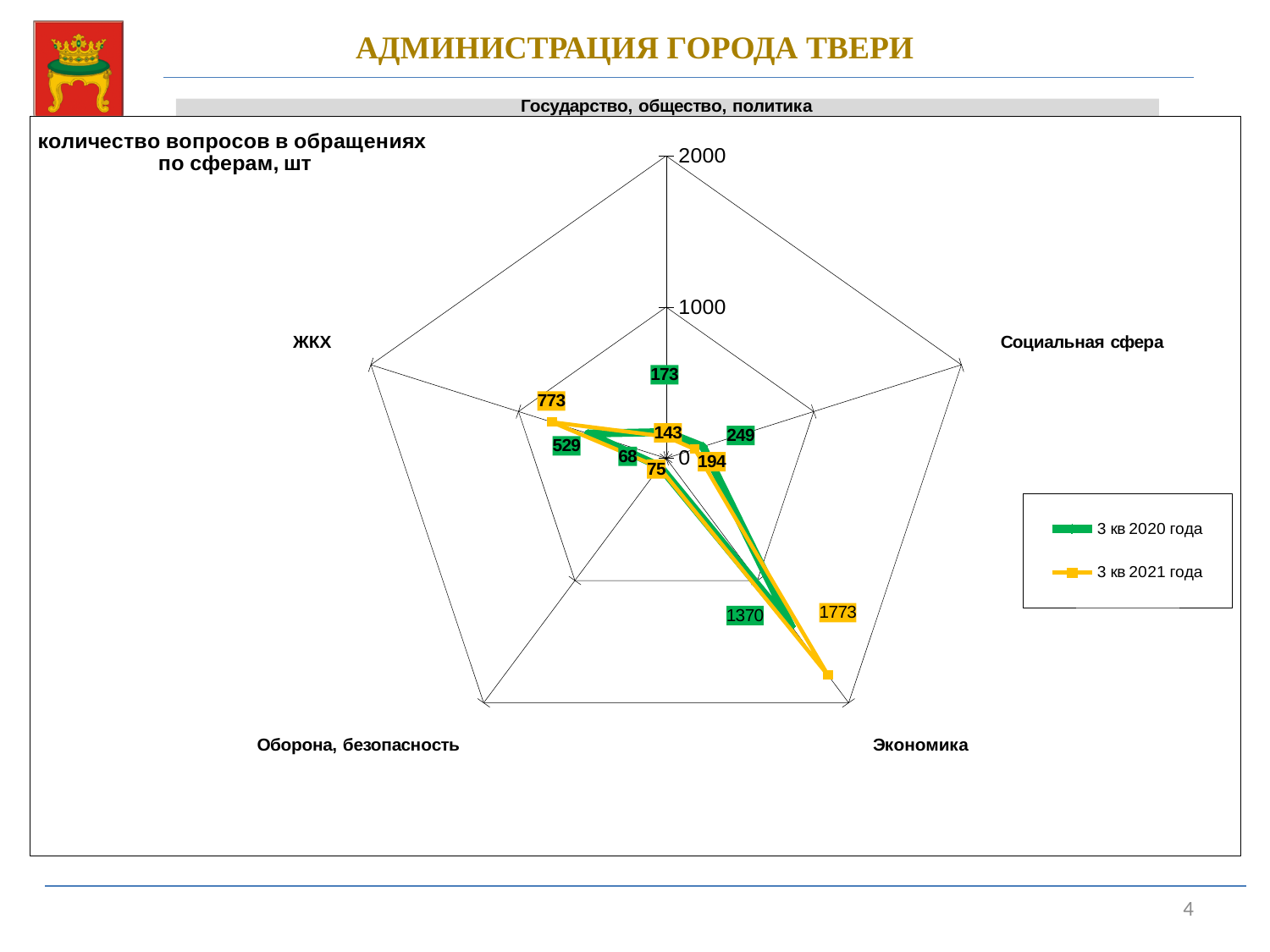
What is the value for ЖКХ in the 3 кв 2021 года series? 773 What is the title of the chart? количество вопросов в обращениях по сферам, шт What is the difference between the 3 кв 2021 года and 3 кв 2020 года values for Экономика? 403 Which category has the highest value in the 3 кв 2021 года series? Экономика What is the value for Социальная сфера in the 3 кв 2020 года series? 249 Which series has the larger value for ЖКХ, 3 кв 2020 года or 3 кв 2021 года? 3 кв 2021 года What is the value for Экономика in the 3 кв 2021 года series? 1773 Which category has the lowest value in the 3 кв 2020 года series? Оборона, безопасность What kind of chart is shown on the slide? radar chart How many categories (axes) does the radar chart have? 5 What is the value for Экономика in the 3 кв 2020 года series? 1370 How many series does the legend list? 2